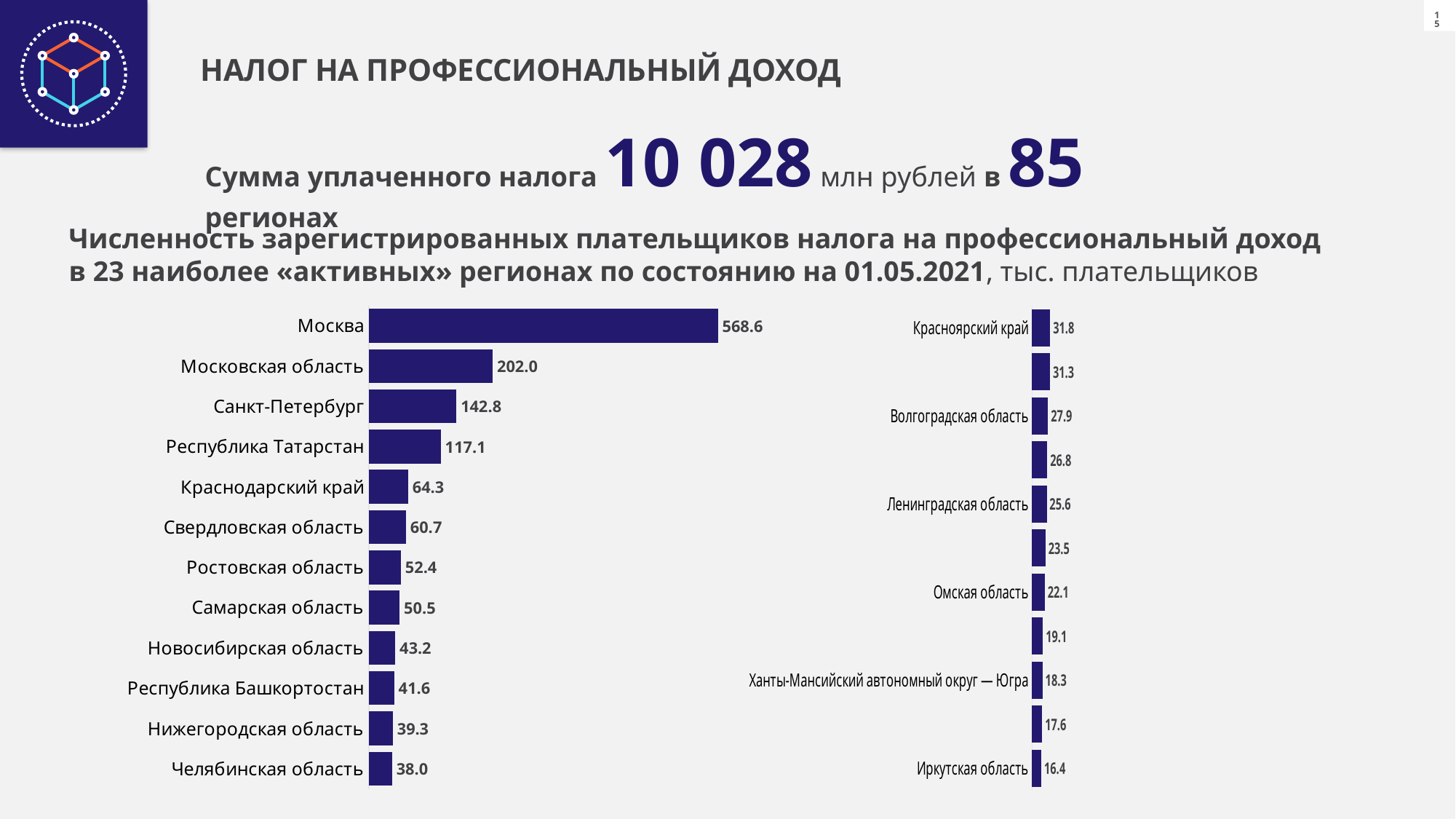
What type of chart is used on this slide? Bar chart How many bars are shown in the left chart? 12 In the right chart, what is the value for Волгоградская область? 27.9 In the left chart, which is larger: the value for Краснодарский край or Свердловская область? Краснодарский край In the left chart, what is the difference between the values for Москва and Московская область? 366.6 In the right chart, what is the difference between the values for Красноярский край and Омская область? 9.7 In the right chart, which labelled region has the lowest value? Иркутская область In the left chart, which region has the highest value? Москва In the left chart, which region has the lowest value? Челябинская область In the right chart, what is the value for Ханты-Мансийский автономный округ — Югра? 18.3 In the left chart, what is the value for Москва? 568.6 In the left chart, what is the value for Республика Татарстан? 117.1